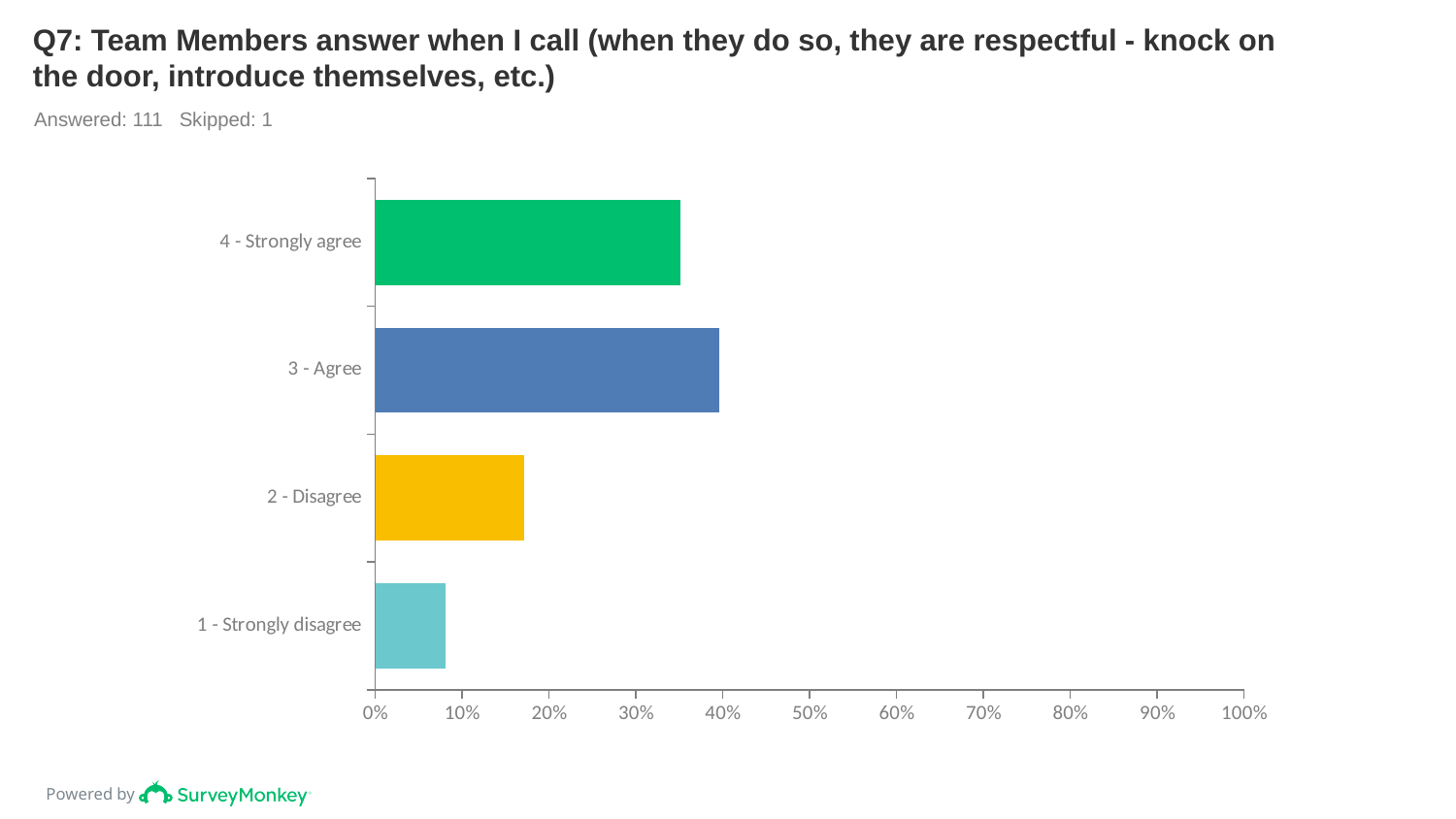
Which is larger, the value for 4 - Strongly agree or the value for 2 - Disagree? 4 - Strongly agree Is the value for 2 - Disagree greater or less than 10%? greater What is the highest value shown on the horizontal axis? 100% How many response categories are shown in the chart? 4 Is the value for 1 - Strongly disagree greater or less than 10%? less Is the value for 4 - Strongly agree greater or less than 40%? less Which response category has the highest value? 3 - Agree How many respondents answered this question according to the slide? 111 Which response category has the lowest value? 1 - Strongly disagree Which is larger, the value for 2 - Disagree or the value for 1 - Strongly disagree? 2 - Disagree What kind of chart is shown on the slide? bar chart